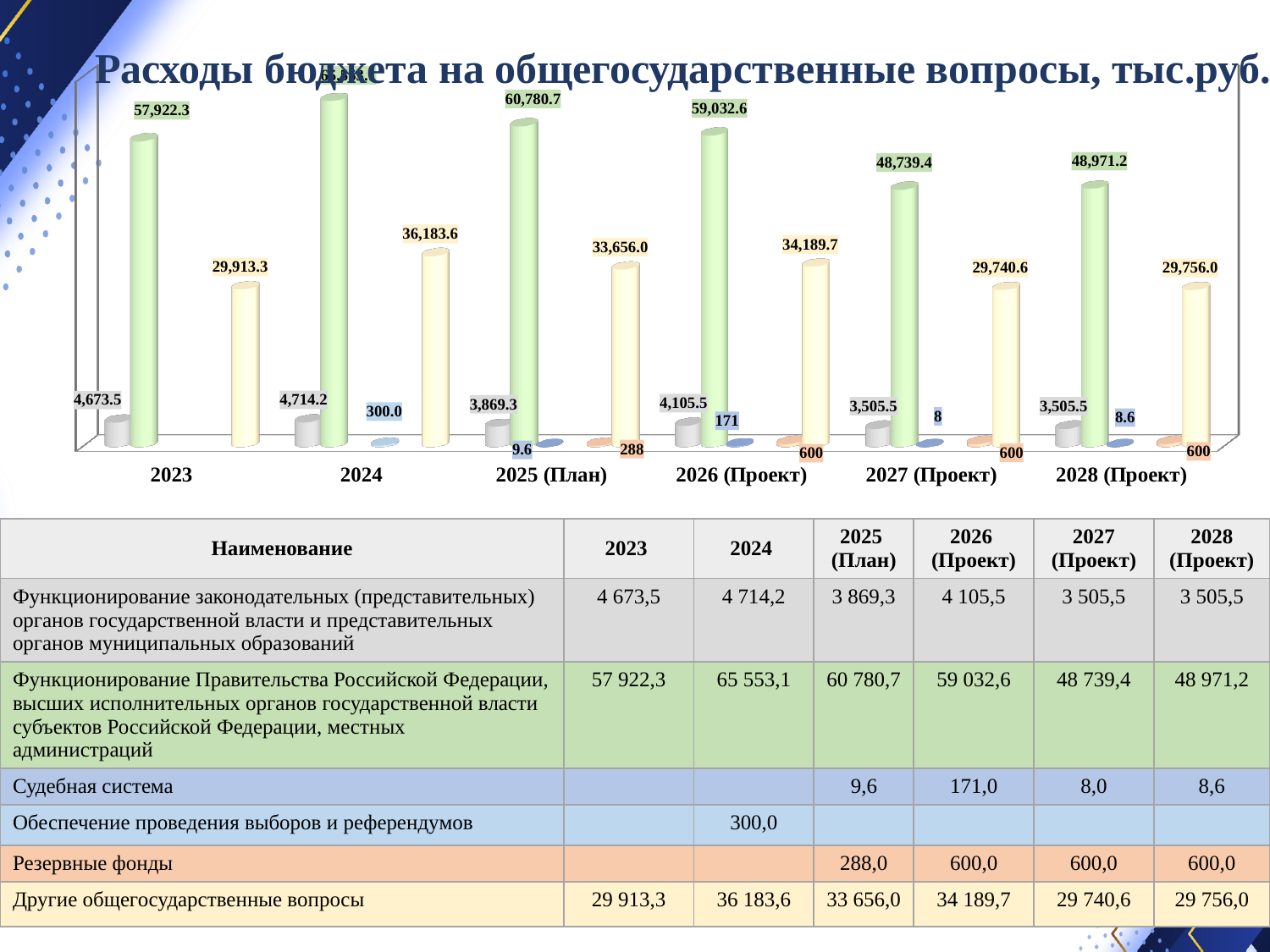
What is the value of the tallest (green) bar for 2023 in the chart? 57,922.3 What kind of chart is shown on the slide? bar chart What is the title of the chart? Расходы бюджета на общегосударственные вопросы, тыс.руб. What is the value labelled for Судебная система in 2026 (Проект) on the chart? 171 How many year categories are shown along the x axis of the chart? 6 In which year is the green bar (Функционирование Правительства Российской Федерации...) the lowest? 2027 (Проект) What is the difference between the green bar values for 2025 (План) and 2026 (Проект)? 1,748.1 What is the value of the yellow bar (Другие общегосударственные вопросы) for 2026 (Проект)? 34,189.7 Does the green bar rise or fall from 2025 (План) to 2027 (Проект)? fall Which year has the larger yellow bar (Другие общегосударственные вопросы): 2024 or 2025 (План)? 2024 In which year is the green bar (Функционирование Правительства Российской Федерации...) the highest? 2024 What is the value labelled for Резервные фонды in 2025 (План) on the chart? 288